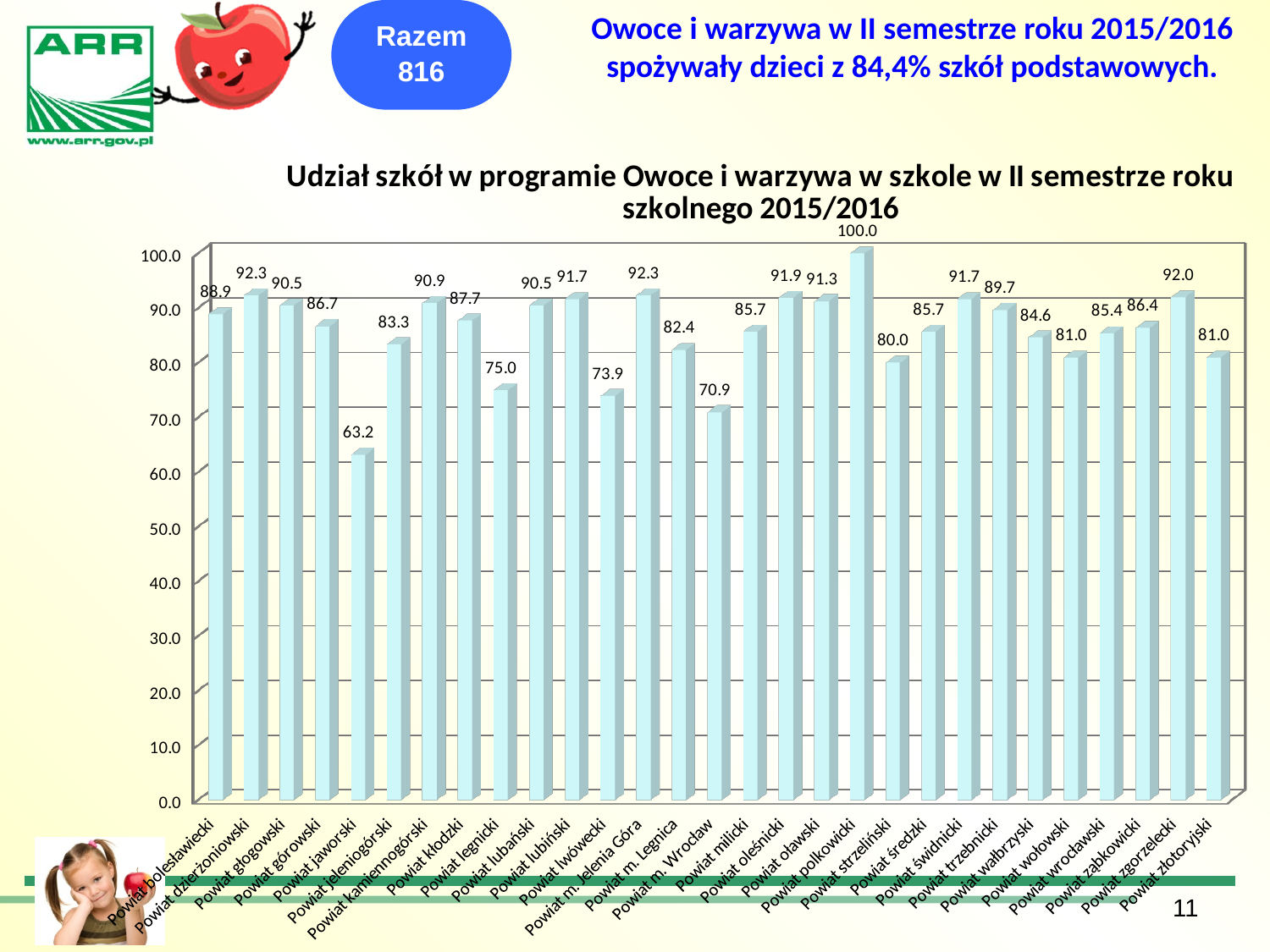
How many powiats (bars) are shown in the chart? 29 What is the title of the chart? Udział szkół w programie Owoce i warzywa w szkole w II semestrze roku szkolnego 2015/2016 Is the value for Powiat strzeliński greater or less than 90.0? less Which powiat has the lowest value in the chart? Powiat jaworski What is the difference between the values for Powiat polkowicki and Powiat jaworski? 36.8 What is the value for Powiat polkowicki? 100.0 What type of chart is shown on the slide? bar chart What is the value for Powiat zgorzelecki? 92.0 Which powiat has the highest value in the chart? Powiat polkowicki What is the value for Powiat jaworski? 63.2 Which is larger, the value for Powiat legnicki or the value for Powiat lwówecki? Powiat legnicki What is the value for Powiat m. Wrocław? 70.9